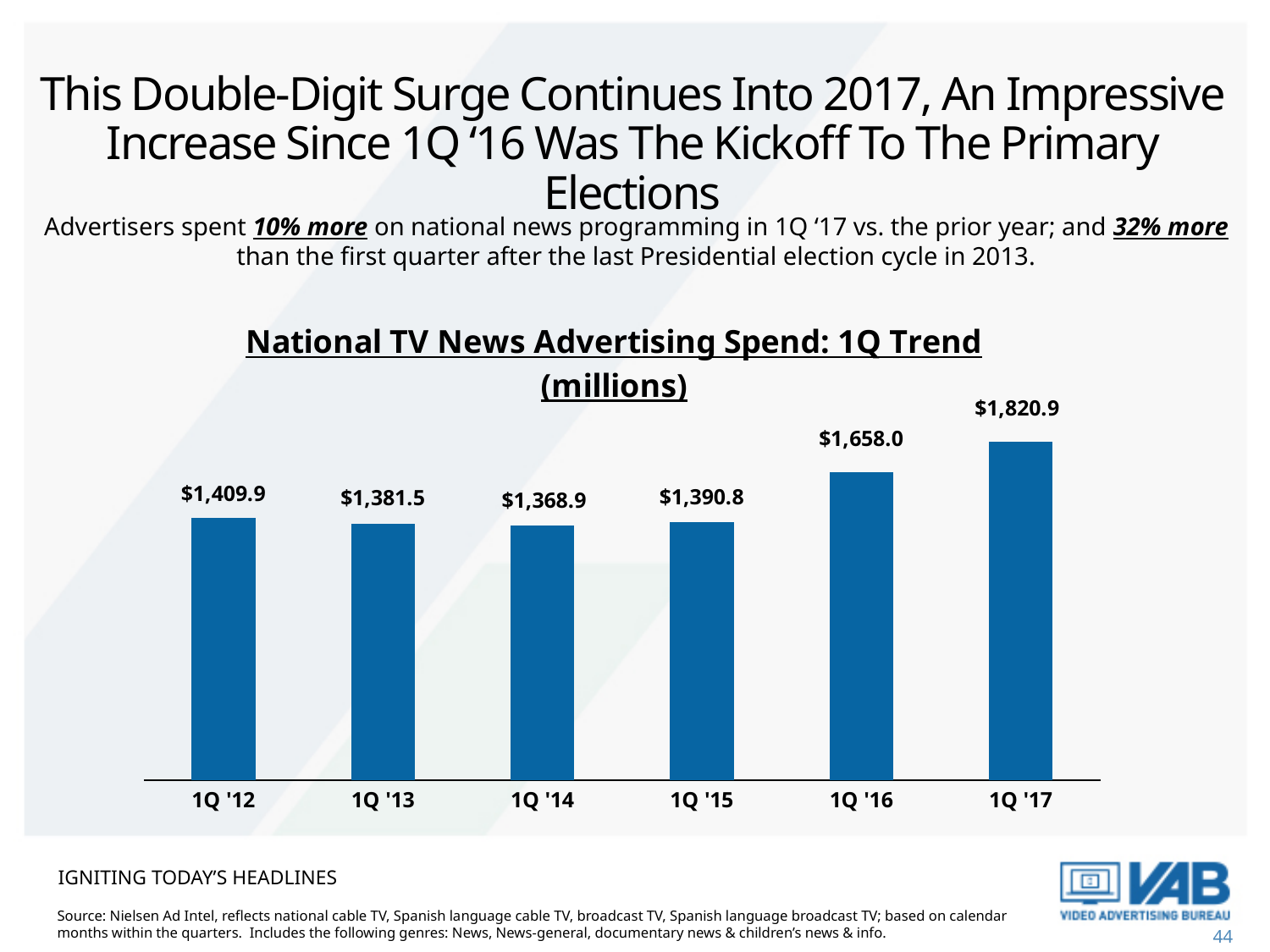
What is the value for 1Q '14? $1,368.9 What kind of chart is this? Bar chart What is the value for 1Q '17? $1,820.9 What is the title of the chart? National TV News Advertising Spend: 1Q Trend (millions) What is the value for 1Q '12? $1,409.9 What is the difference between the values for 1Q '16 and 1Q '15? $267.2 Which quarter has the lowest advertising spend? 1Q '14 How many quarters are shown on the chart? 6 Which is larger, the value for 1Q '12 or the value for 1Q '13? 1Q '12 Do the values rise or fall from 1Q '15 to 1Q '17? Rise Which quarter has the highest advertising spend? 1Q '17 What is the difference between the values for 1Q '17 and 1Q '16? $162.9